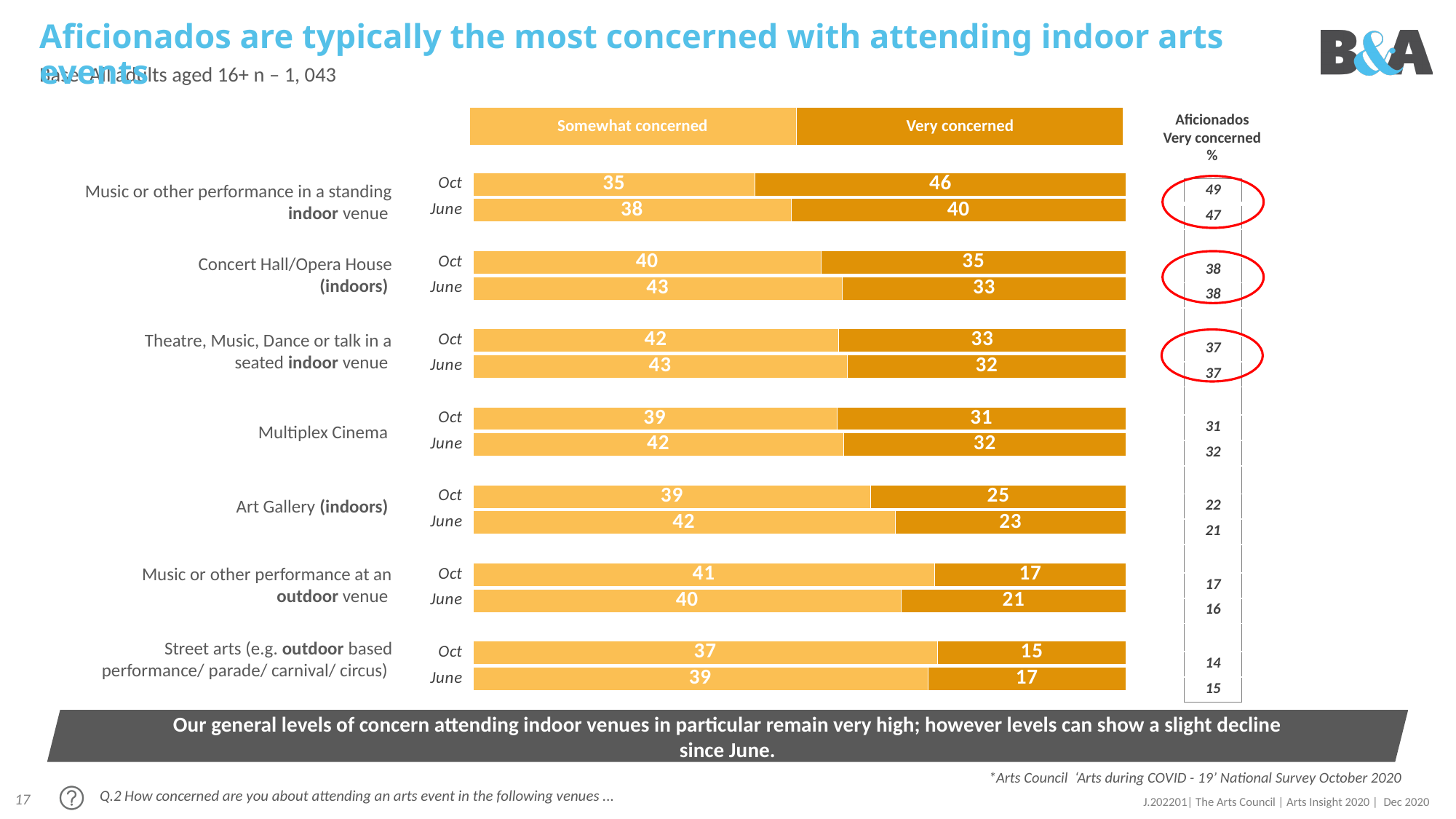
What are the two legend entries of the chart? Somewhat concerned, Very concerned Which venue has the lowest 'Very concerned' value in Oct? Street arts (e.g. outdoor based performance/ parade/ carnival/ circus) Which has the larger 'Very concerned' value in Oct: 'Art Gallery (indoors)' or 'Multiplex Cinema'? Multiplex Cinema What is the Aficionados 'Very concerned %' for 'Concert Hall/Opera House (indoors)' in Oct? 38 What is the total of the Oct stacked bar for 'Music or other performance in a standing indoor venue'? 81 How many venue categories are shown in the chart? 7 What kind of chart is shown on the slide? Stacked bar chart By how much did the 'Very concerned' value for 'Music or other performance in a standing indoor venue' change from June to Oct? 6 What is the 'Very concerned' value for 'Music or other performance in a standing indoor venue' in Oct? 46 How many series does the legend list? 2 Which venue has the highest 'Very concerned' value in Oct? Music or other performance in a standing indoor venue What is the 'Somewhat concerned' value for 'Concert Hall/Opera House (indoors)' in June? 43